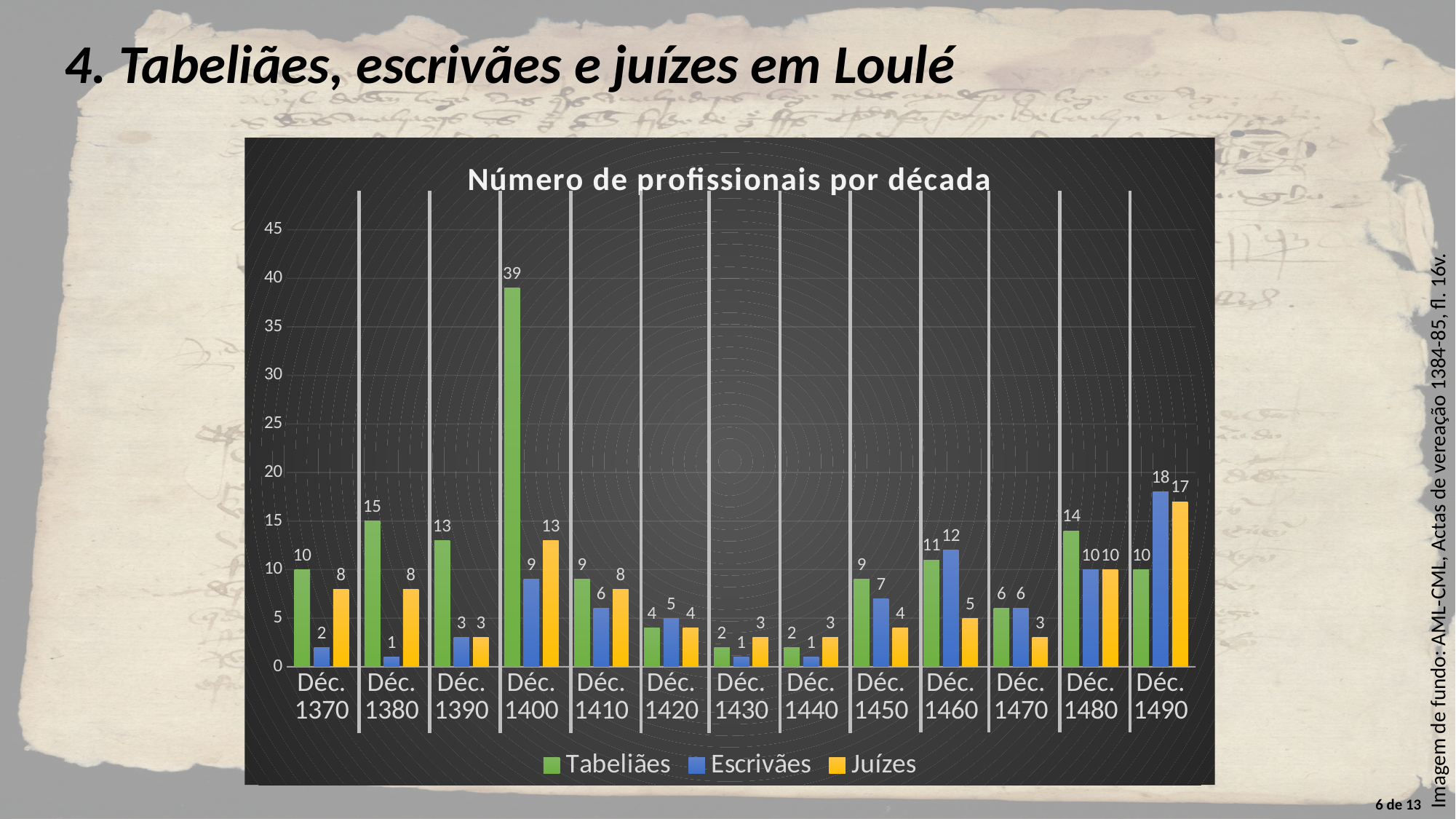
In which decade is the Tabeliães value highest? Déc. 1400 How many series does the legend list? 3 What is the value for Tabeliães in Déc. 1400? 39 What is the title of the chart? Número de profissionais por década Is the value for Tabeliães in Déc. 1400 greater or less than 35? greater How many decades are shown on the x axis? 13 What is the difference between the Tabeliães and Escrivães values in Déc. 1400? 30 What is the value for Juízes in Déc. 1370? 8 Which is larger in Déc. 1460, Tabeliães or Escrivães? Escrivães What is the value for Escrivães in Déc. 1490? 18 What kind of chart is shown on the slide? bar chart In which decade is the Juízes value highest? Déc. 1490